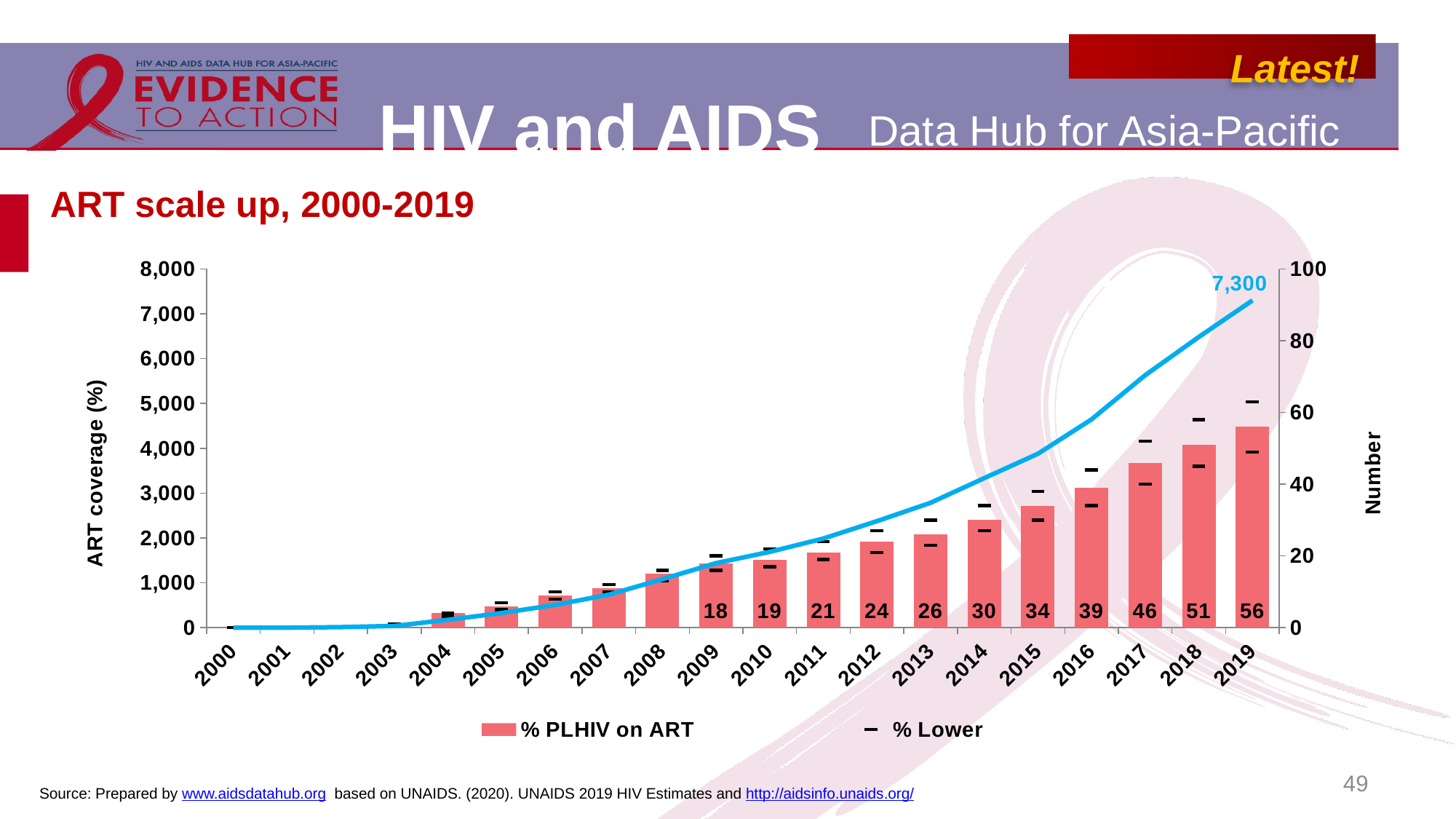
Which year has a larger % PLHIV on ART value, 2012 or 2014? 2014 What is the difference between the % PLHIV on ART values for 2019 and 2009? 38 What is the title of the chart? ART scale up, 2000-2019 How many years are shown on the x axis of the chart? 20 What value is labelled on the blue line at 2019? 7,300 How many series does the legend list? 2 What is the % PLHIV on ART value shown for 2019? 56 What is the difference between the % PLHIV on ART values for 2018 and 2017? 5 What is the % PLHIV on ART value shown for 2015? 34 Which year has the highest % PLHIV on ART bar? 2019 Do the % PLHIV on ART bars rise or fall from 2009 to 2019? rise What is the % PLHIV on ART value shown for 2009? 18